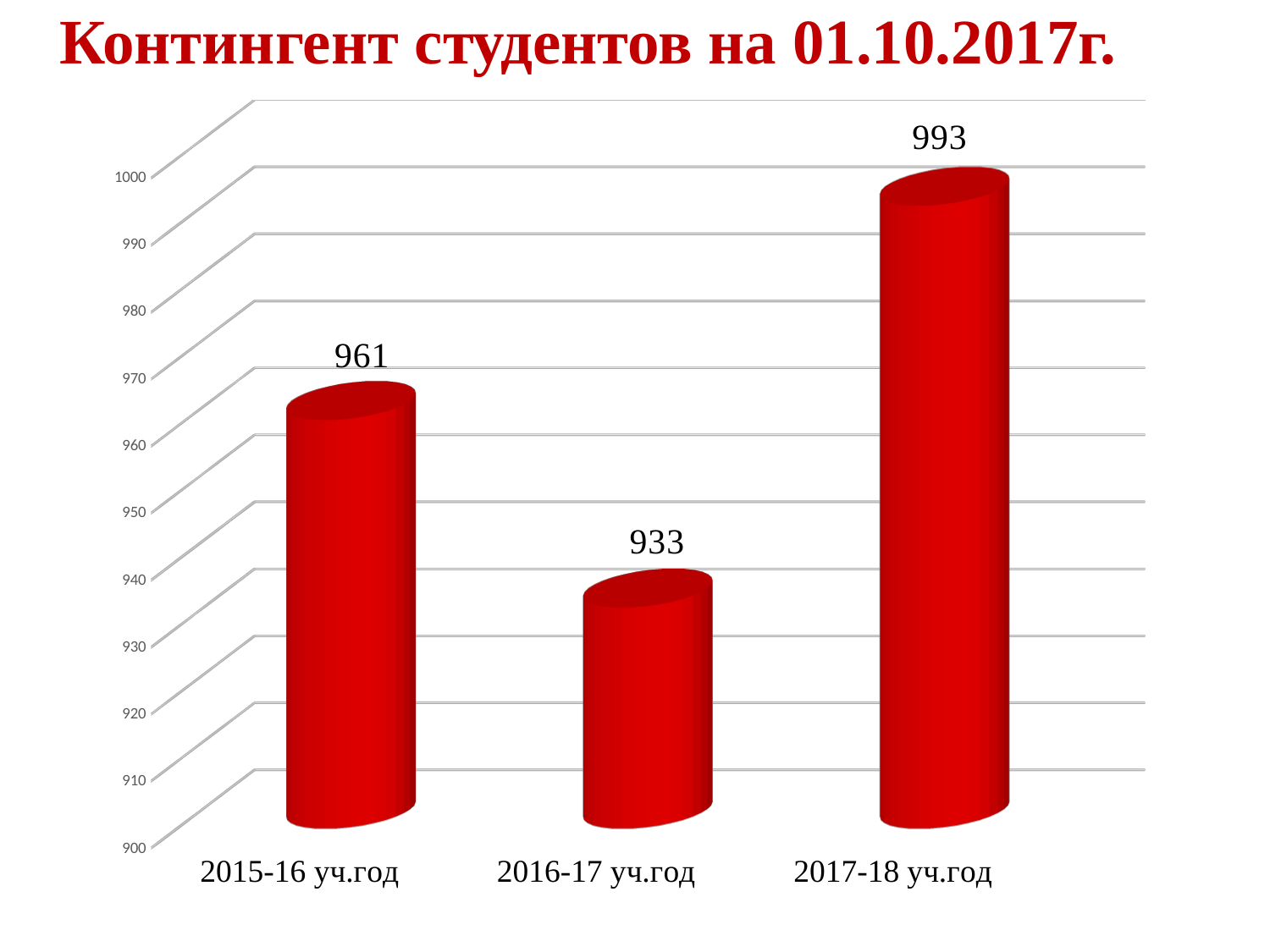
What is the value for 2017-18 уч.год? 993 What kind of chart is shown on the slide? bar chart What is the difference between the values for 2015-16 уч.год and 2016-17 уч.год? 28 Is the value for 2016-17 уч.год greater or less than 950? less Which is larger, the value for 2015-16 уч.год or 2017-18 уч.год? 2017-18 уч.год Which academic year has the lowest value? 2016-17 уч.год What is the title of the chart? Контингент студентов на 01.10.2017г. What is the value for 2016-17 уч.год? 933 What is the difference between the values for 2017-18 уч.год and 2016-17 уч.год? 60 What is the value for 2015-16 уч.год? 961 How many academic years are shown on the chart? 3 Which academic year has the highest value? 2017-18 уч.год